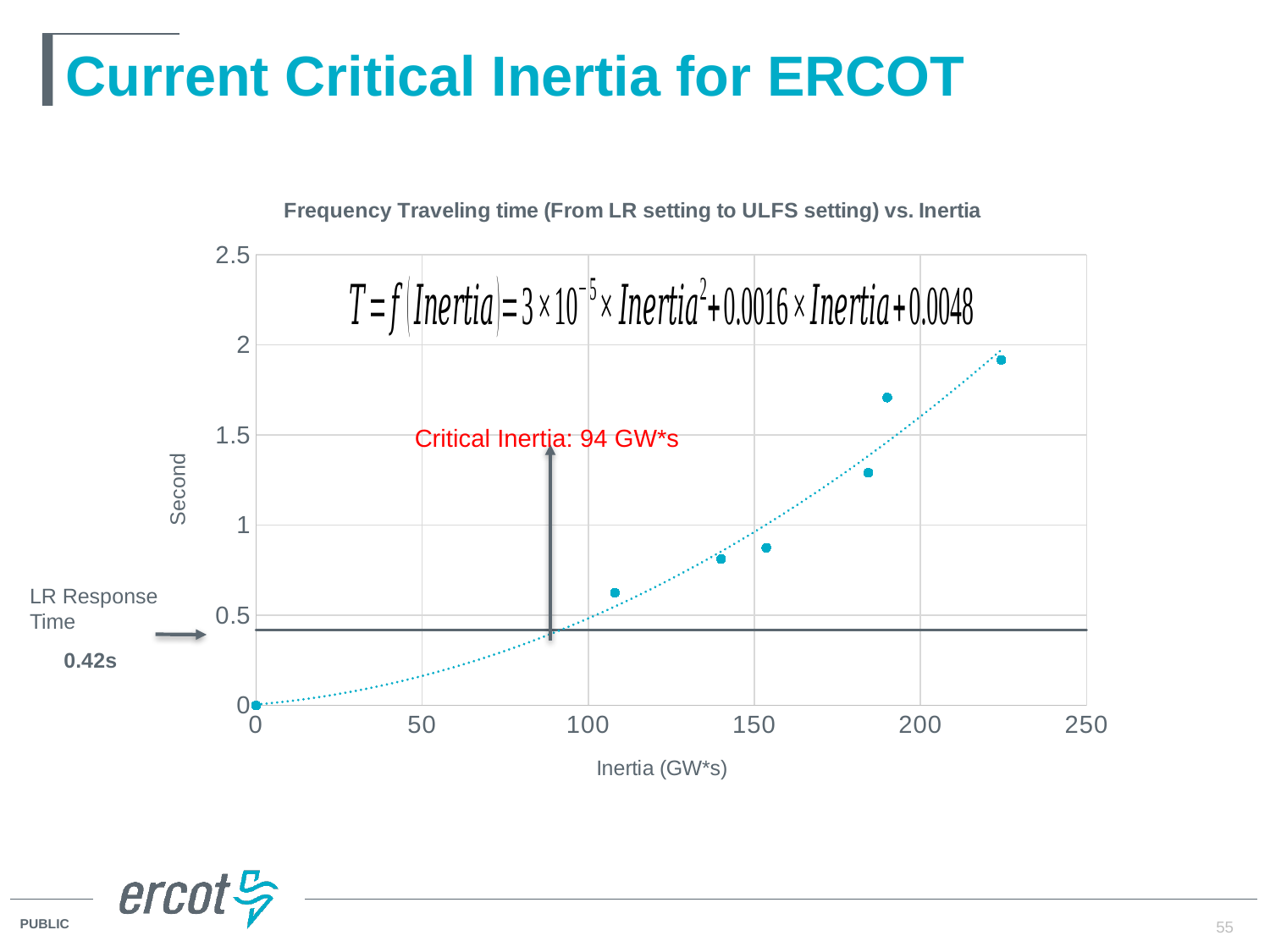
Is the value for the data point at about 140 GW*s inertia greater or less than 0.5 seconds? greater Is the value for the data point at about 225 GW*s inertia greater or less than 1.5 seconds? greater Which plotted data point has the highest value on the y axis: the one at about 225 GW*s or the one at about 190 GW*s? the one at about 225 GW*s Is the value for the data point at about 190 GW*s inertia greater or less than 1.5 seconds? greater How many data points are plotted on the chart? 7 What is the label of the x axis? Inertia (GW*s) What kind of chart is shown on the slide? scatter chart What is the maximum value shown on the y axis of the chart? 2.5 What is the title of the chart? Frequency Traveling time (From LR setting to ULFS setting) vs. Inertia Do the plotted values rise or fall as inertia increases along the x axis? rise